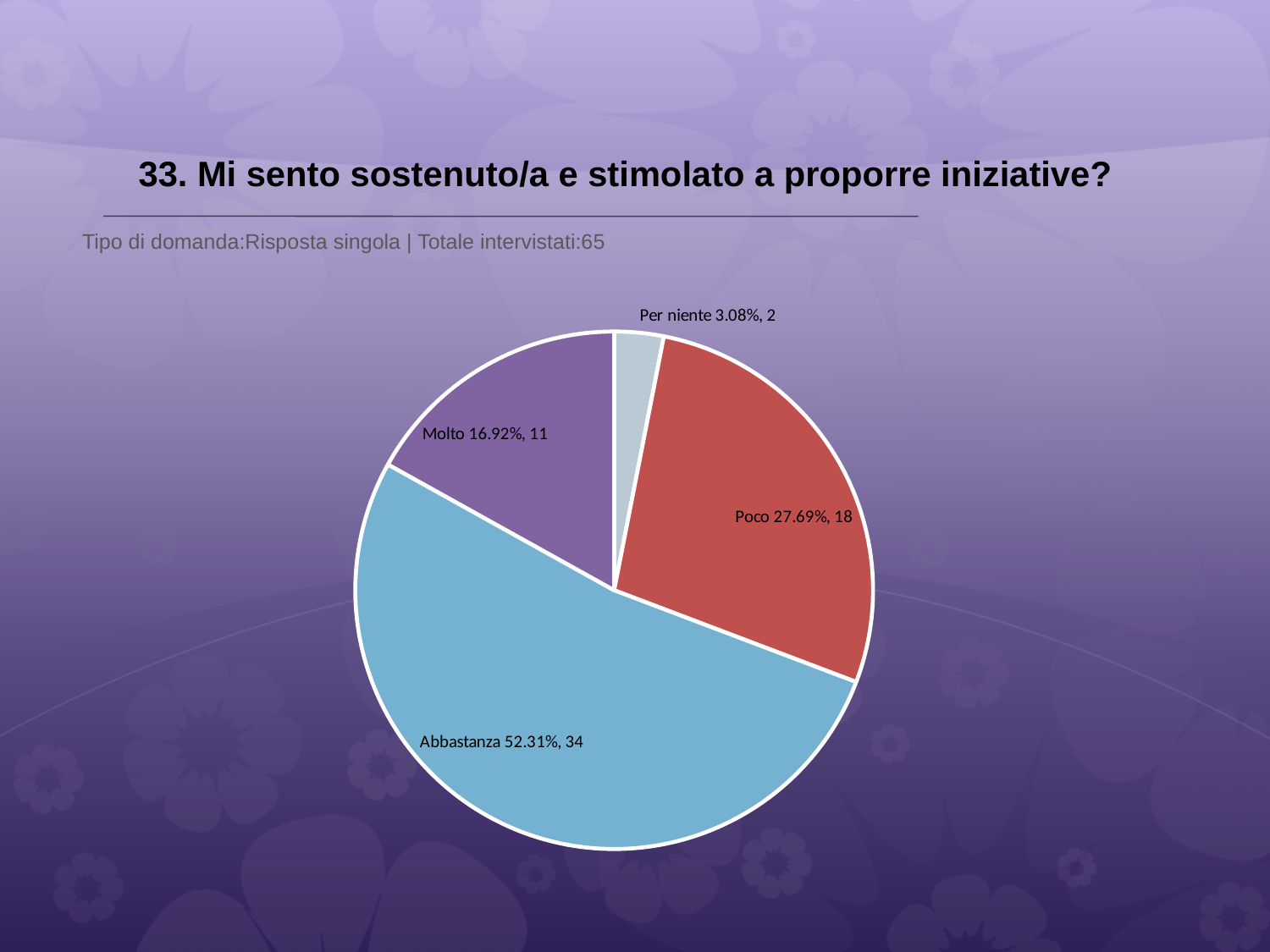
What percentage share does the 'Abbastanza' slice have? 52.31% What colour is the 'Abbastanza' slice? light blue What is the difference in respondent count between 'Abbastanza' and 'Poco'? 16 What is the total number of respondents stated on the slide? 65 What kind of chart is shown on the slide? pie chart How many slices does the pie chart have? 4 How many respondents answered 'Per niente'? 2 What percentage is shown for 'Molto'? 16.92% Which category has the largest slice? Abbastanza How many respondents answered 'Poco'? 18 Which has more respondents, 'Molto' or 'Poco'? Poco Which category has the smallest slice? Per niente